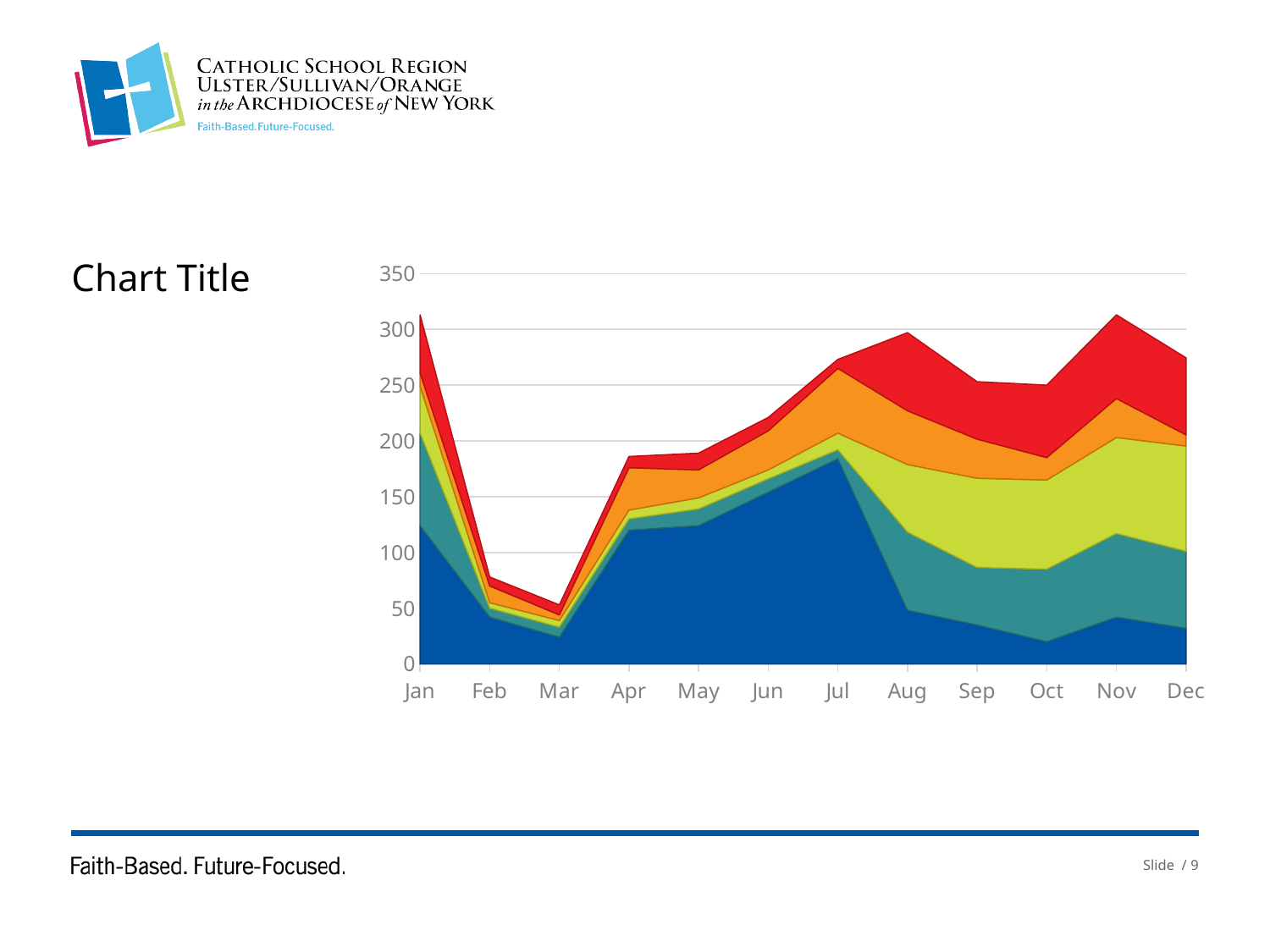
Is the stacked total for Mar greater or less than 100? less Is the stacked total for Feb greater or less than 100? less Does the stacked total rise or fall from Jan to Mar? fall Is the value of the bottom (dark blue) series in Jul greater or less than 150? greater Which month has the larger stacked total, Aug or Sep? Aug What is the title of the chart? Chart Title In which month is the stacked total lowest? Mar How many coloured series are stacked in the chart? 5 How many months are shown along the x axis of the chart? 12 What kind of chart is shown on the slide? Stacked area chart